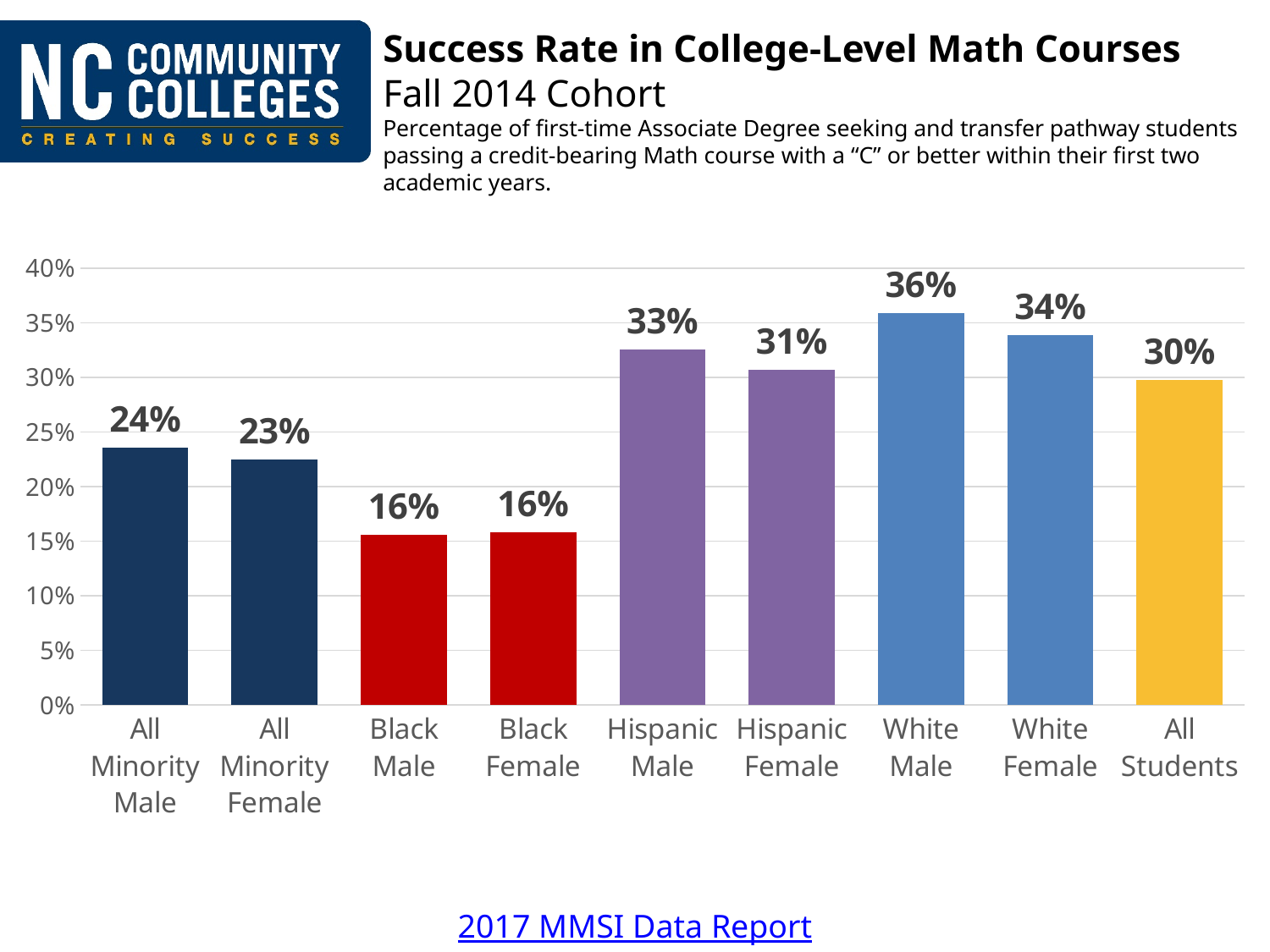
What is the success rate for All Minority Female students? 23% What is the success rate for White Male students? 36% Which is larger, the success rate for White Female or for All Students? White Female Is the value for All Minority Male greater or less than 20%? greater What colour are the bars for Black Male and Black Female? Red What kind of chart is shown on the slide? Bar chart What is the difference in success rate between Hispanic Male and Hispanic Female students? 2% What is the title of the chart? Success Rate in College-Level Math Courses How many categories are shown on the x axis? 9 What is the difference in success rate between White Male and Black Male students? 20% Which category has the highest success rate? White Male What is the success rate for All Students? 30%